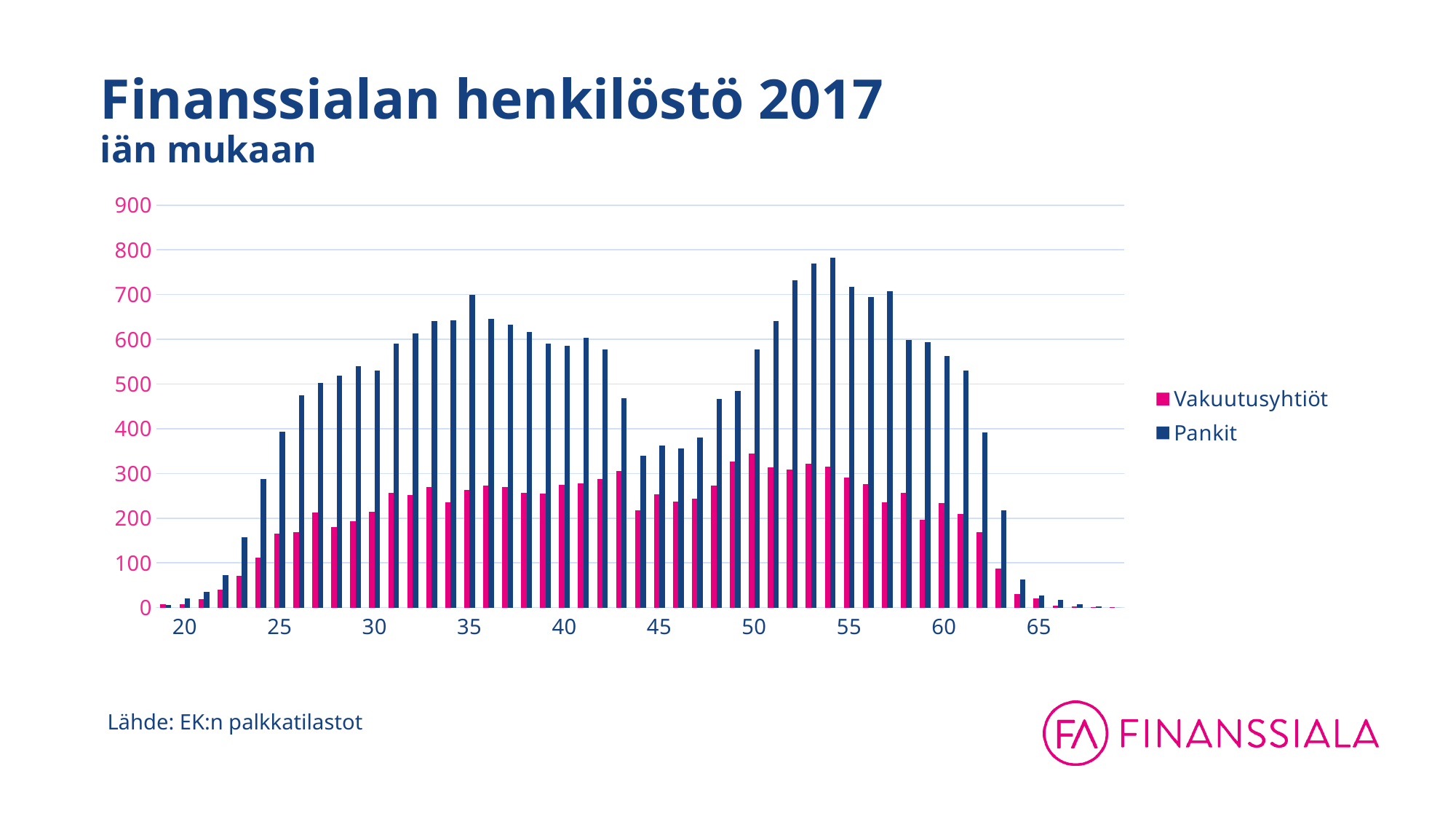
Is the Pankit value at age 54 greater or less than 700? greater Is the Pankit value at age 45 greater or less than 400? less Is the Vakuutusyhtiöt value at age 40 greater or less than 300? less At age 45, which series has the larger value, Pankit or Vakuutusyhtiöt? Pankit Which is larger for Pankit: the value at age 54 or the value at age 45? age 54 Do the Pankit values rise or fall from age 62 to age 65? fall What kind of chart is shown on the slide? bar chart What is the title of the chart on the slide? Finanssialan henkilöstö 2017 iän mukaan Which two series are listed in the legend? Vakuutusyhtiöt and Pankit How many series does the legend list? 2